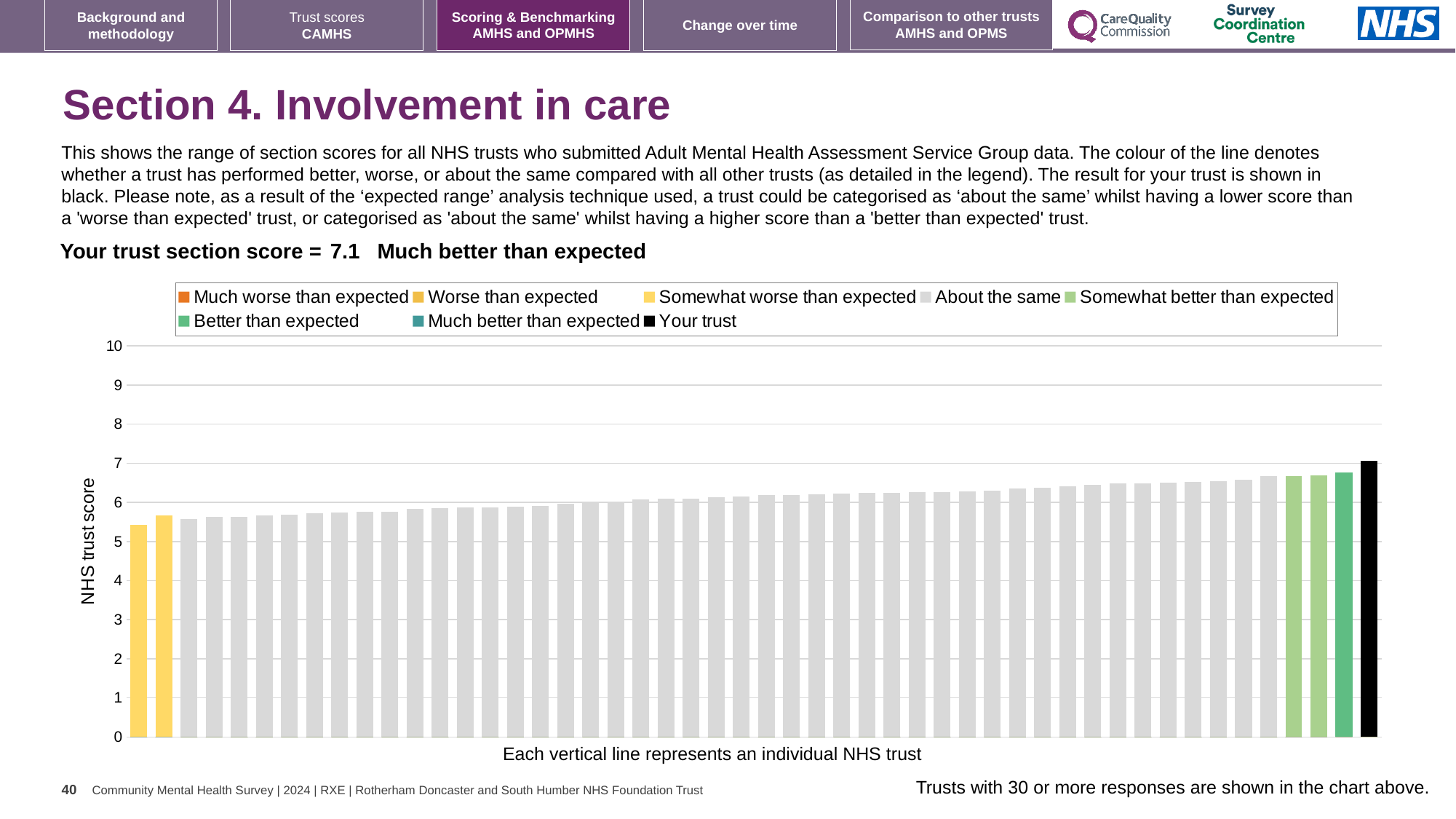
What kind of chart is shown on the slide? bar chart Which is larger, the leftmost bar or the rightmost bar? the rightmost bar Is the value of the lowest bar in the chart greater or less than 5? greater What is the label on the vertical axis of the chart? NHS trust score How is your trust's section score categorised according to the slide? Much better than expected Is the value of the lowest bar in the chart greater or less than 6? less Do the bar values rise or fall from left to right along the x axis? rise Is the value for your trust greater or less than 6? greater How many entries does the chart legend list? 8 Which bar in the chart is the highest? Your trust (the black bar) How many bars in the chart are coloured yellow? 2 What is the section score for your trust shown on the slide? 7.1